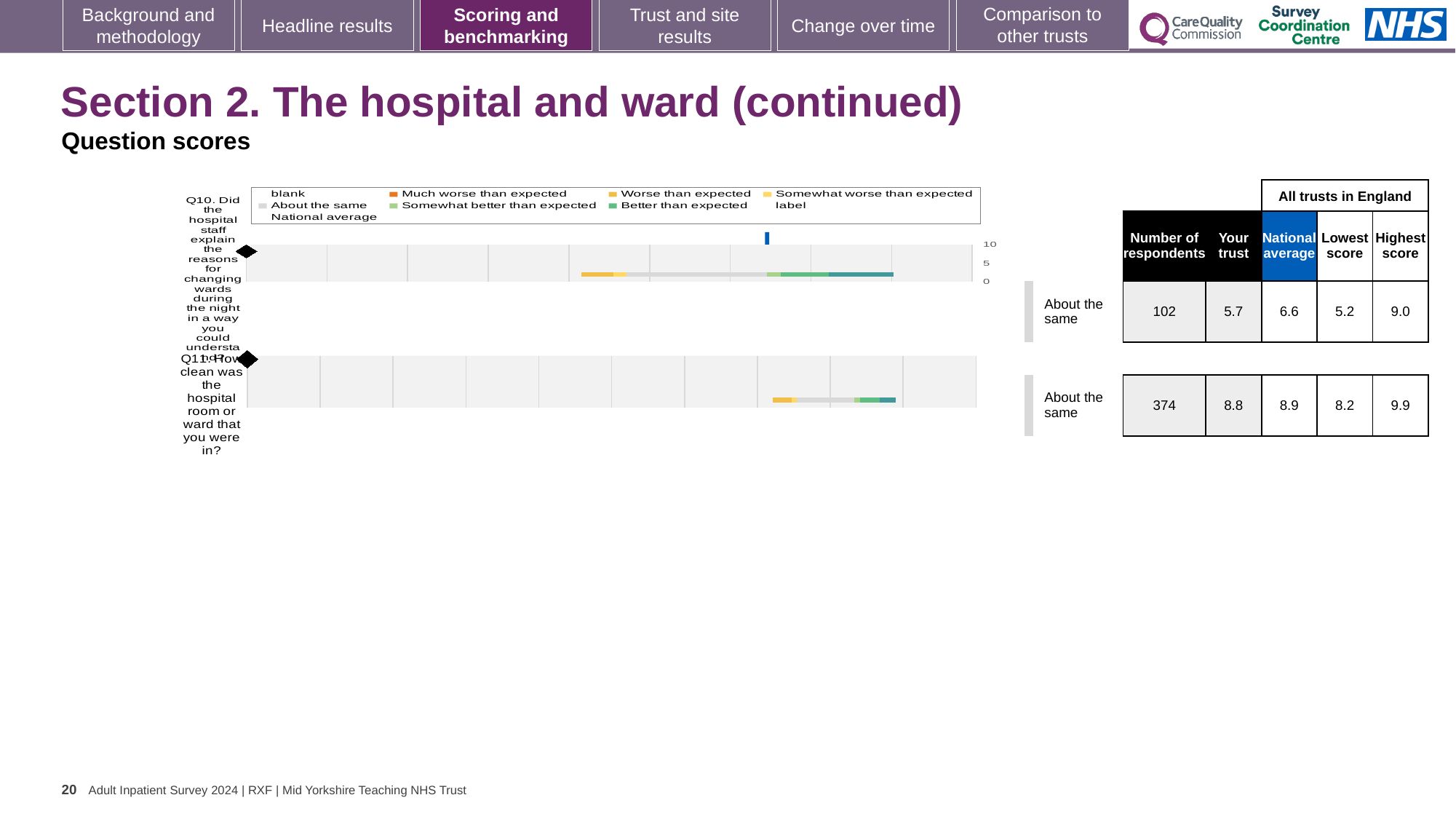
What kind of chart is used to show the question scores on this slide? Bar chart How many respondents answered Q10 (explaining reasons for changing wards during the night)? 102 How many respondents answered Q11 about how clean the hospital room or ward was? 374 For Q10 about explaining reasons for changing wards, what is the difference between the highest score and the lowest score among all trusts in England? 3.8 What is the 'Your trust' score for Q10 about explaining reasons for changing wards during the night? 5.7 For Q11 about cleanliness of the room or ward, what is the difference between the national average and the 'Your trust' score? 0.1 For Q10 about explaining reasons for changing wards, which is larger: the 'Your trust' score or the national average? National average How many survey questions are plotted on this slide? 2 What is the lowest score among all trusts in England for Q11 about how clean the hospital room or ward was? 8.2 What is the highest score among all trusts in England for Q11 about how clean the hospital room or ward was? 9.9 What benchmark category is shown for Q10 about explaining reasons for changing wards during the night? About the same What is the national average score for Q10 about explaining reasons for changing wards during the night? 6.6